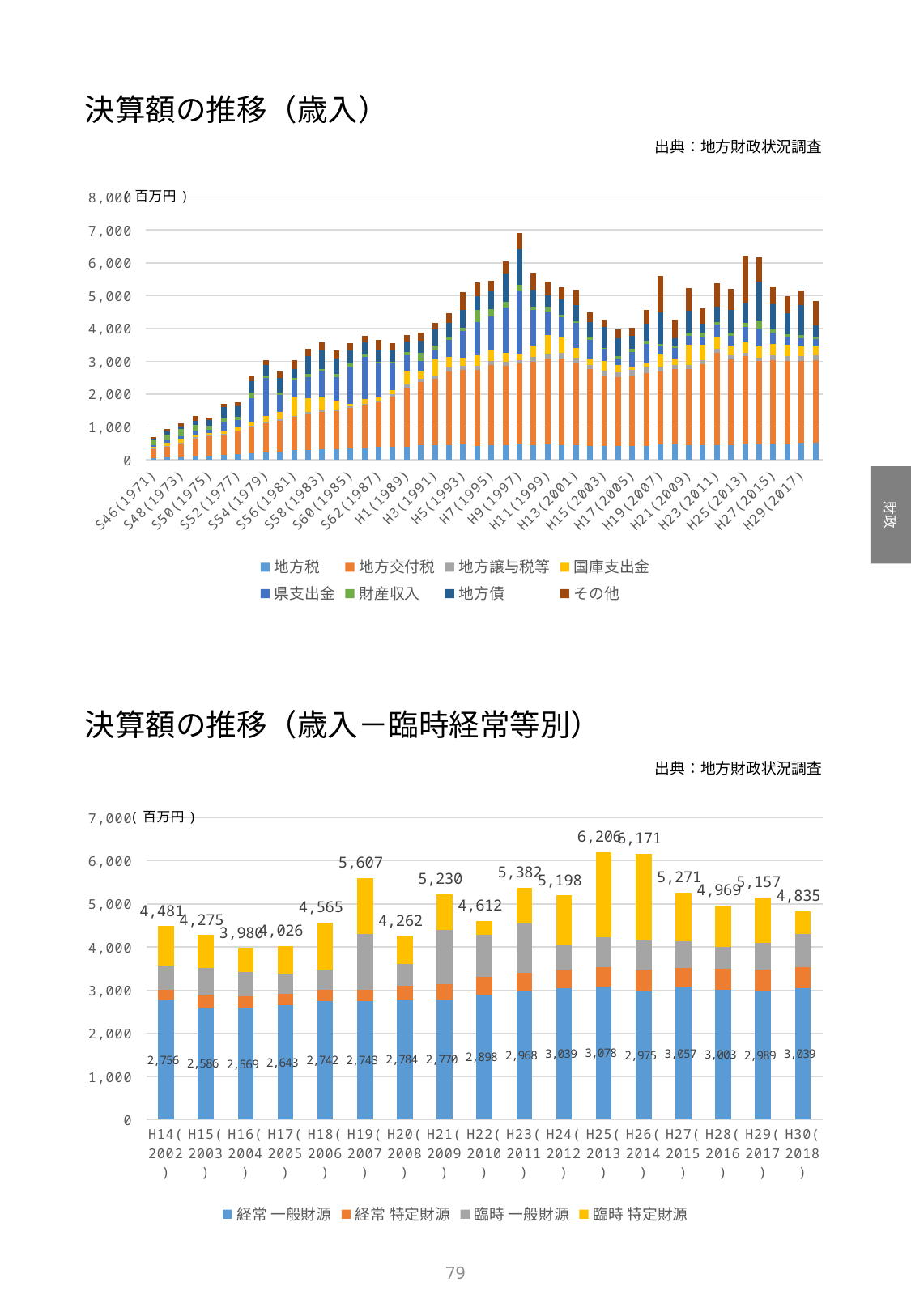
In the bottom chart (決算額の推移（歳入－臨時経常等別）), what is the value of 経常 一般財源 for H14(2002)? 2,756 In the bottom chart (決算額の推移（歳入－臨時経常等別）), which is larger, the 経常 一般財源 value for H25(2013) or for H26(2014)? H25(2013) In the bottom chart (決算額の推移（歳入－臨時経常等別）), what is the difference between the 経常 一般財源 values for H30(2018) and H14(2002)? 283 In the bottom chart (決算額の推移（歳入－臨時経常等別）), which year has the highest total? H25(2013) How many years (bars) are shown in the bottom chart (決算額の推移（歳入－臨時経常等別）)? 17 In the bottom chart (決算額の推移（歳入－臨時経常等別）), which year has the lowest total? H16(2004) In the bottom chart (決算額の推移（歳入－臨時経常等別）), what is the total value labelled for H25(2013)? 6,206 In the bottom chart (決算額の推移（歳入－臨時経常等別）), what is the difference between the totals for H25(2013) and H26(2014)? 35 What kind of chart is the top chart (決算額の推移（歳入）)? Stacked bar chart How many series does the legend of the bottom chart (決算額の推移（歳入－臨時経常等別）) list? 4 How many series does the legend of the top chart (決算額の推移（歳入）) list? 8 In the top chart (決算額の推移（歳入）), is the total for H9(1997) greater or less than 6,000? greater